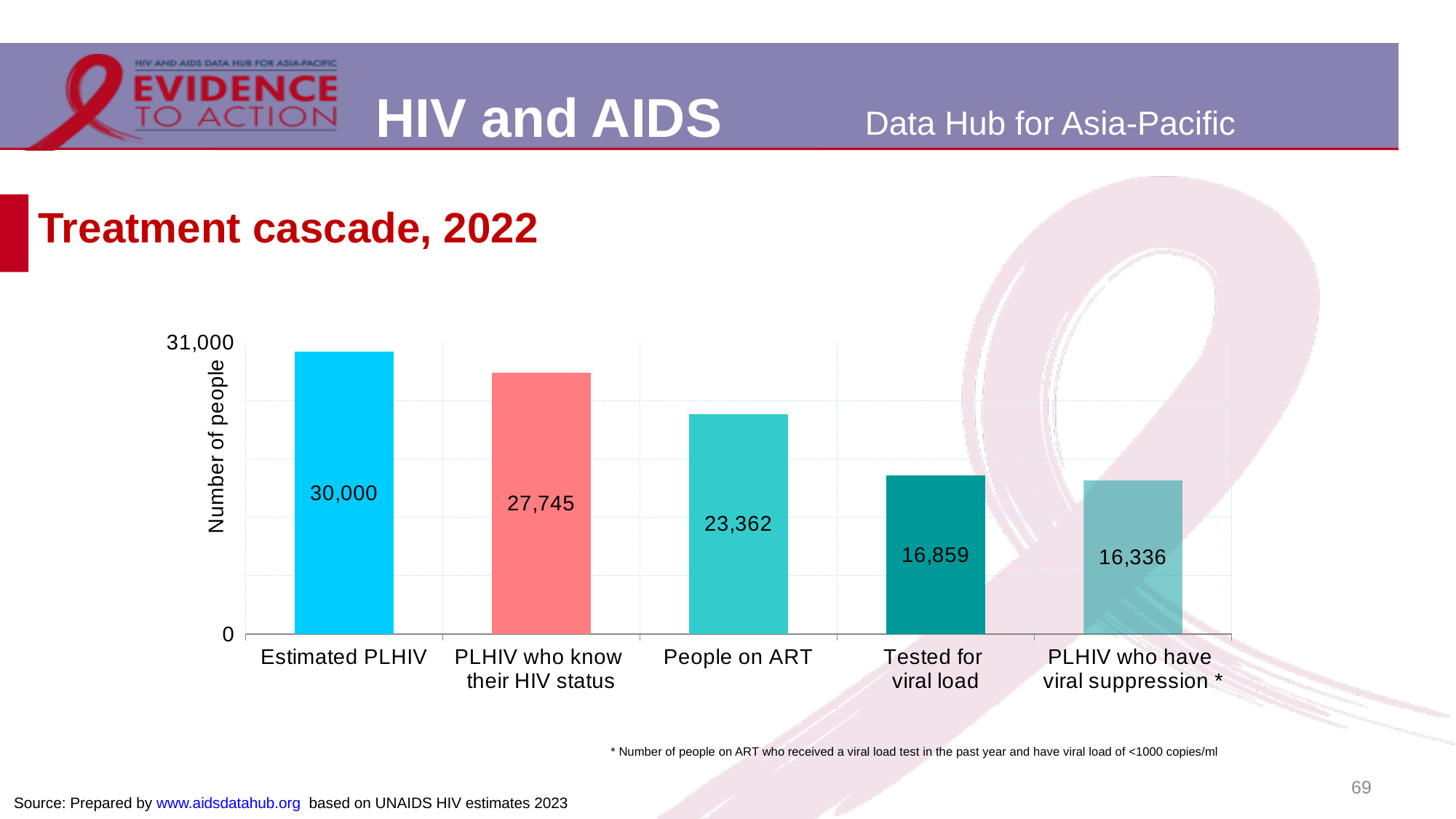
How many categories are shown on the chart? 5 What is the difference between Estimated PLHIV and People on ART? 6,638 What is the value for PLHIV who know their HIV status? 27,745 What is the value for Estimated PLHIV? 30,000 What is the value for PLHIV who have viral suppression? 16,336 Which category has the highest value? Estimated PLHIV What kind of chart is shown on the slide? Bar chart Which category has the lowest value? PLHIV who have viral suppression Which is larger, PLHIV who know their HIV status or People on ART? PLHIV who know their HIV status What is the value for People on ART? 23,362 What is the difference between Tested for viral load and PLHIV who have viral suppression? 523 What is the value for Tested for viral load? 16,859